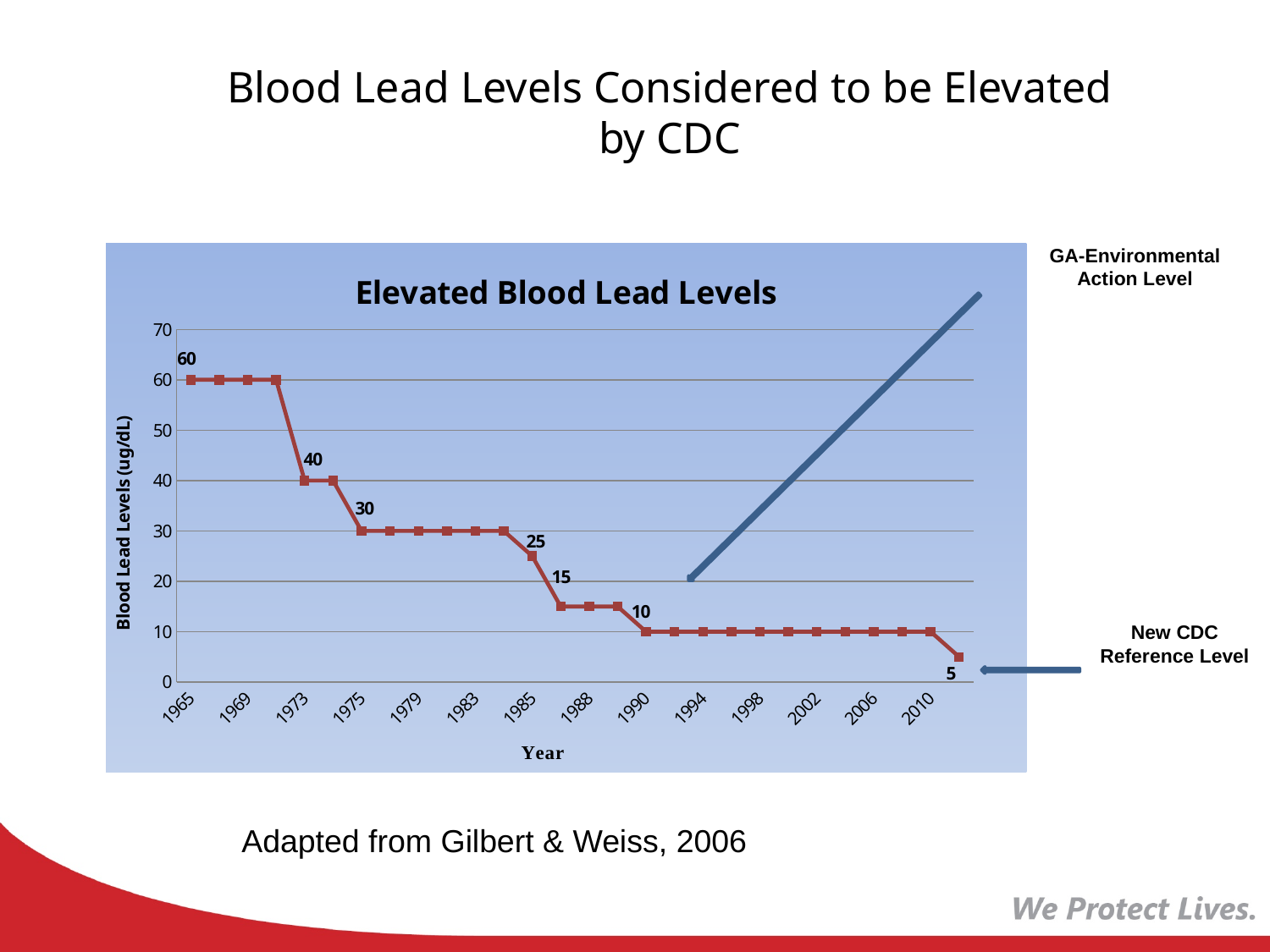
What is the blood lead level value plotted for 1973? 40 What is the title of the chart? Elevated Blood Lead Levels What is the blood lead level value plotted for 1985? 25 What is the difference between the value for 1973 and the value for 1975? 10 What is the highest blood lead level value shown on the line? 60 What type of chart is shown on the slide? Line chart What is the blood lead level value plotted for 1965? 60 What is the blood lead level value plotted for 1990? 10 Do the blood lead level values rise or fall over the years shown? Fall What is the lowest blood lead level value shown on the line? 5 What is the blood lead level value plotted for 1975? 30 Is the value for 1998 greater or less than 20? less